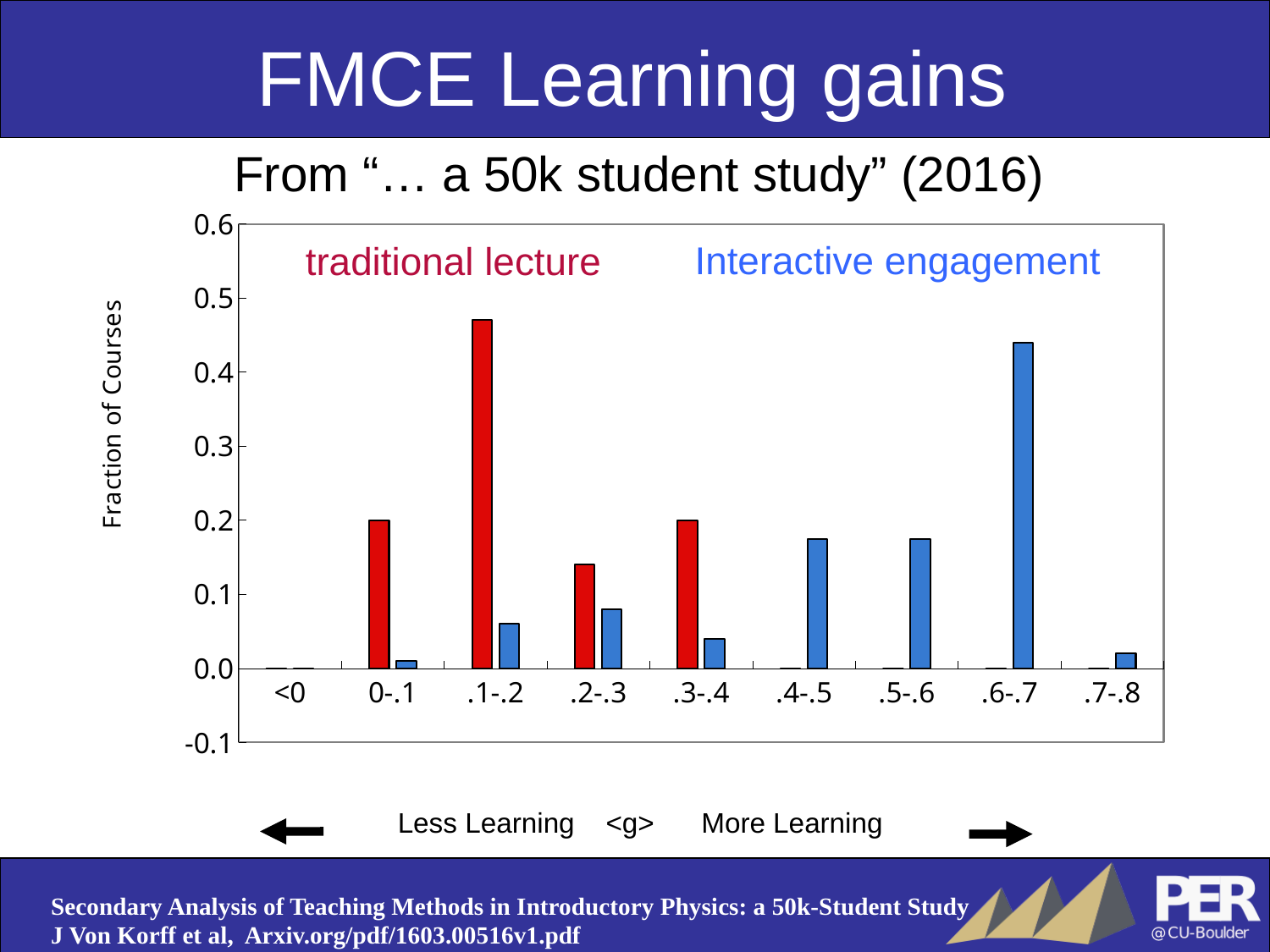
What is the label of the y axis? Fraction of Courses How many series does the chart show? 2 Is the Interactive engagement value for .4-.5 greater or less than 0.1? greater Is the Interactive engagement value for .6-.7 greater or less than 0.5? less How many gain-range categories are shown along the x axis? 9 In the .3-.4 range, which series has the larger fraction of courses, traditional lecture or Interactive engagement? traditional lecture What kind of chart is shown on the slide? bar chart Which series is drawn in red? traditional lecture For which gain range is the traditional lecture fraction of courses highest? .1-.2 For which gain range is the Interactive engagement fraction of courses highest? .6-.7 Is the traditional lecture value for .1-.2 greater or less than 0.4? greater In the .2-.3 range, which series has the larger fraction of courses, traditional lecture or Interactive engagement? traditional lecture